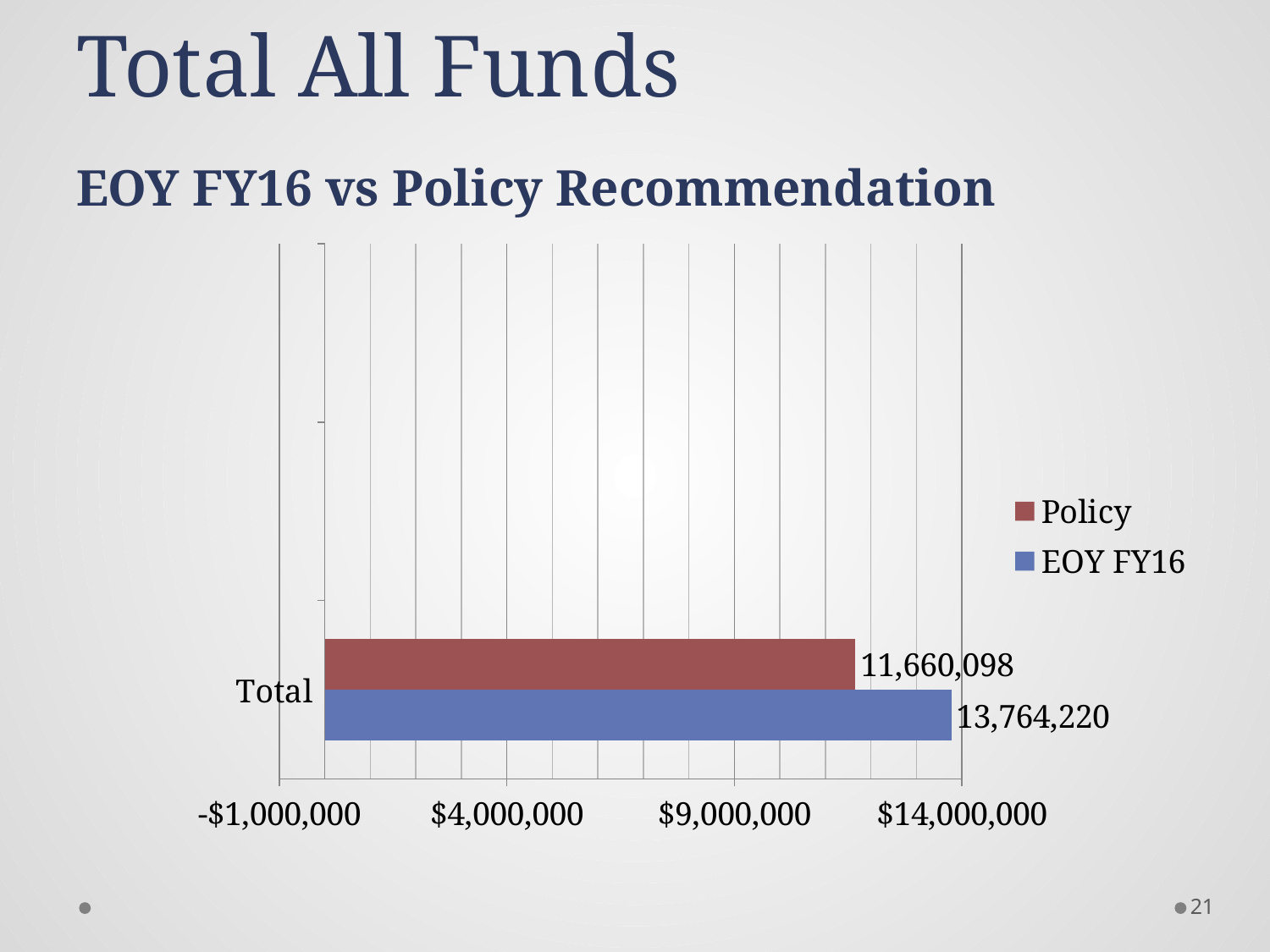
Which series has the lowest value in the chart? Policy What is the label of the category shown on the chart's vertical axis? Total What is the value for Policy in the Total All Funds chart? 11,660,098 What is the difference between the EOY FY16 value and the Policy value? 2,104,122 How many categories are shown on the vertical axis of the chart? 1 Which series is shown in blue in the chart? EOY FY16 Which series has the higher value for Total, Policy or EOY FY16? EOY FY16 What is the value for EOY FY16 in the Total All Funds chart? 13,764,220 Is the value for Policy greater or less than $9,000,000? greater How many series does the legend list? 2 What kind of chart is shown on the slide? Bar chart Is the value for EOY FY16 greater or less than $14,000,000? less